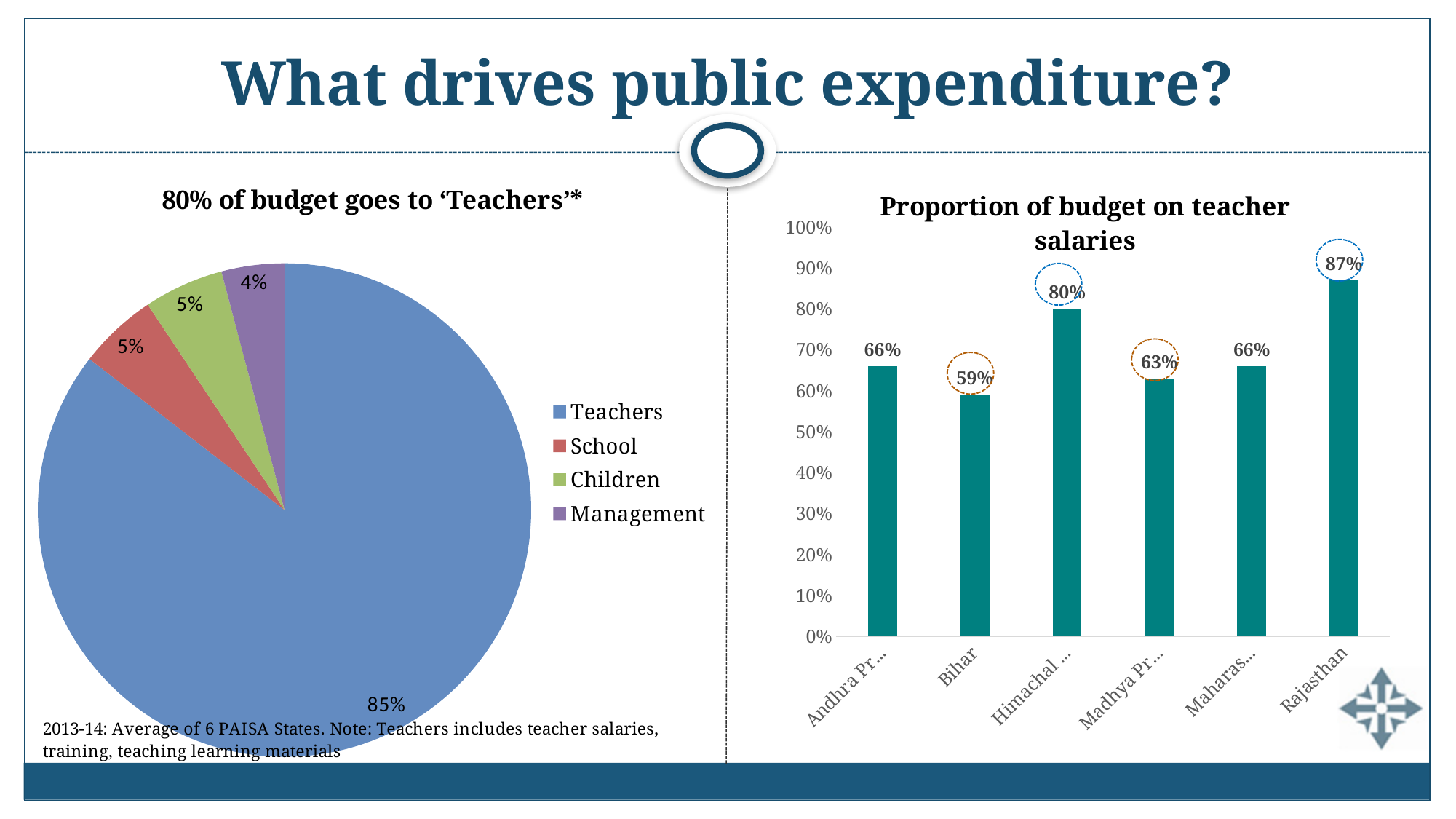
In the 'Proportion of budget on teacher salaries' chart, what is the difference between Rajasthan and Bihar? 28% In the pie chart on the left, what share of the budget goes to Management? 4% In the 'Proportion of budget on teacher salaries' chart, which state has the lowest value? Bihar What type of chart is the 'Proportion of budget on teacher salaries' chart? Bar chart In the pie chart on the left, which category has the smallest slice? Management How many categories does the legend of the pie chart on the left list? 4 What type of chart is the chart on the left of the slide? Pie chart In the 'Proportion of budget on teacher salaries' chart, what is the value for Bihar? 59% In the 'Proportion of budget on teacher salaries' chart, which state has the highest value? Rajasthan How many states are shown in the 'Proportion of budget on teacher salaries' chart? 6 In the pie chart on the left, what share of the budget goes to Teachers? 85% In the 'Proportion of budget on teacher salaries' chart, what is the value for Rajasthan? 87%